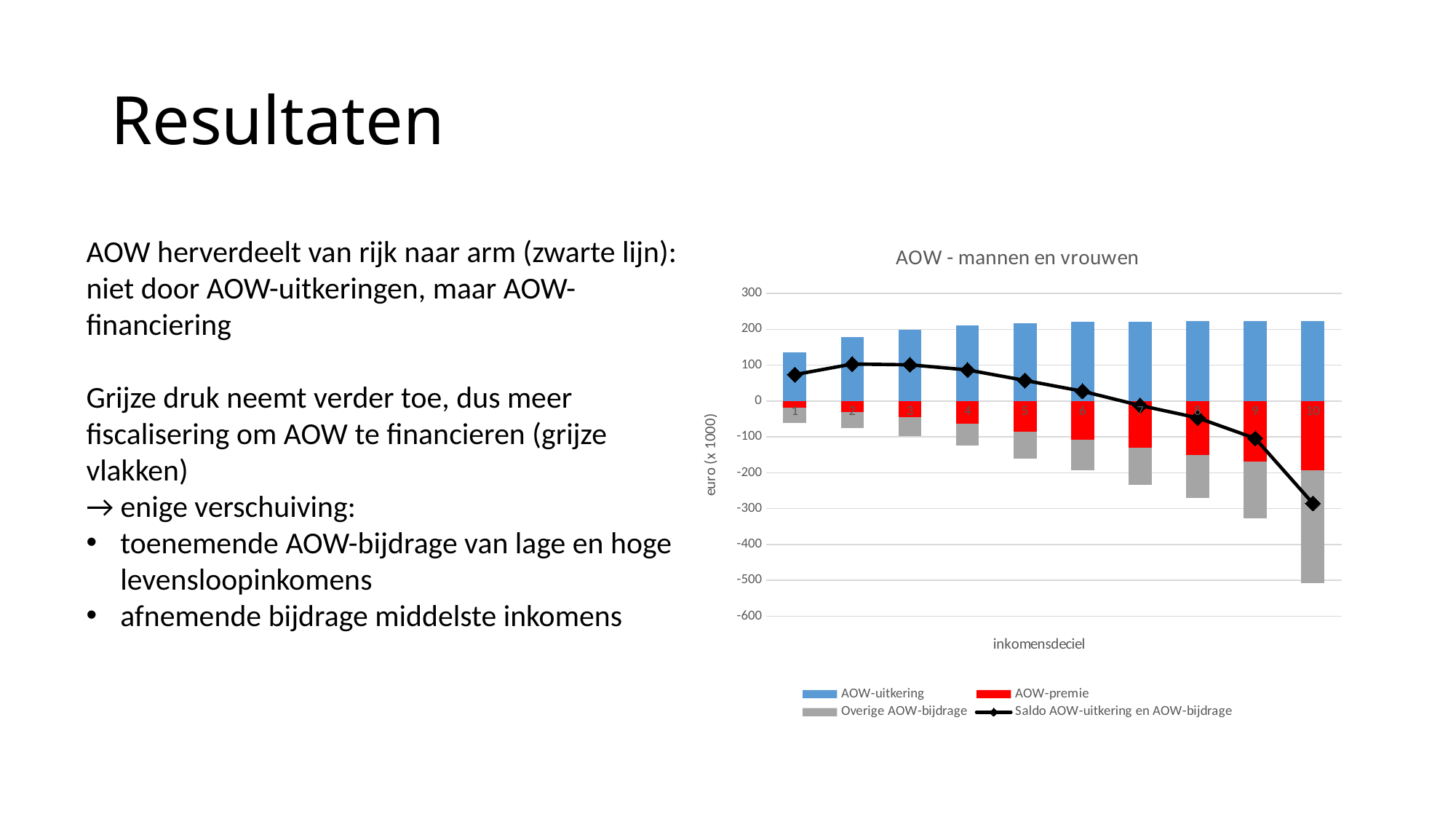
Which income decile has the lowest Saldo AOW-uitkering en AOW-bijdrage value? 10 Which income decile has the smallest AOW-uitkering bar? 1 What kind of chart is shown on the slide? Stacked bar chart with a line Is the Saldo AOW-uitkering en AOW-bijdrage value for decile 10 greater or less than -200? less Is the AOW-uitkering value for decile 1 greater or less than 100? greater How many series does the chart legend list? 4 What is the title of the chart? AOW - mannen en vrouwen Is the AOW-uitkering value for decile 10 greater or less than 200? greater Does the Saldo AOW-uitkering en AOW-bijdrage line rise or fall from decile 3 to decile 10? Fall What is the label of the vertical axis? euro (x 1000) How many income deciles (categories) are plotted on the x axis? 10